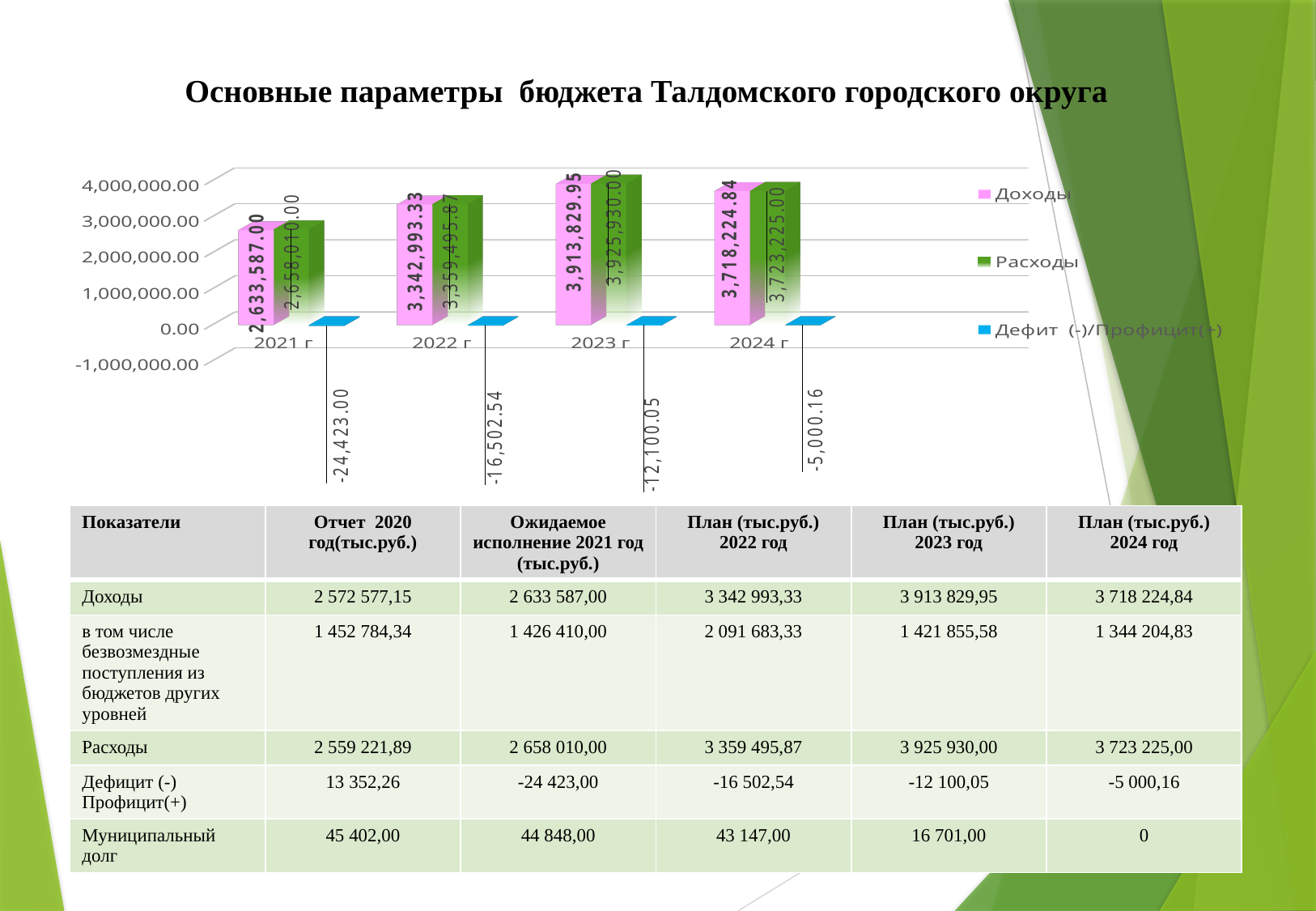
Which colour represents the Доходы series in the chart? pink What is the difference between Расходы and Доходы for 2024 г in the chart? 5,000.16 What is the value of Дефицит (-)/Профицит(+) for 2021 г in the chart? -24,423.00 How many year categories are shown on the x axis of the chart? 4 What is the value of Доходы for 2022 г in the chart? 3,342,993.33 How many series does the chart legend list? 3 In which year is Доходы highest in the chart? 2023 г What is the value of Дефицит (-)/Профицит(+) for 2024 г in the chart? -5,000.16 In which year is Расходы lowest in the chart? 2021 г Which is larger in the chart for 2022 г: Доходы or Расходы? Расходы What type of chart is shown on the slide? bar chart What is the value of Расходы for 2023 г in the chart? 3,925,930.00